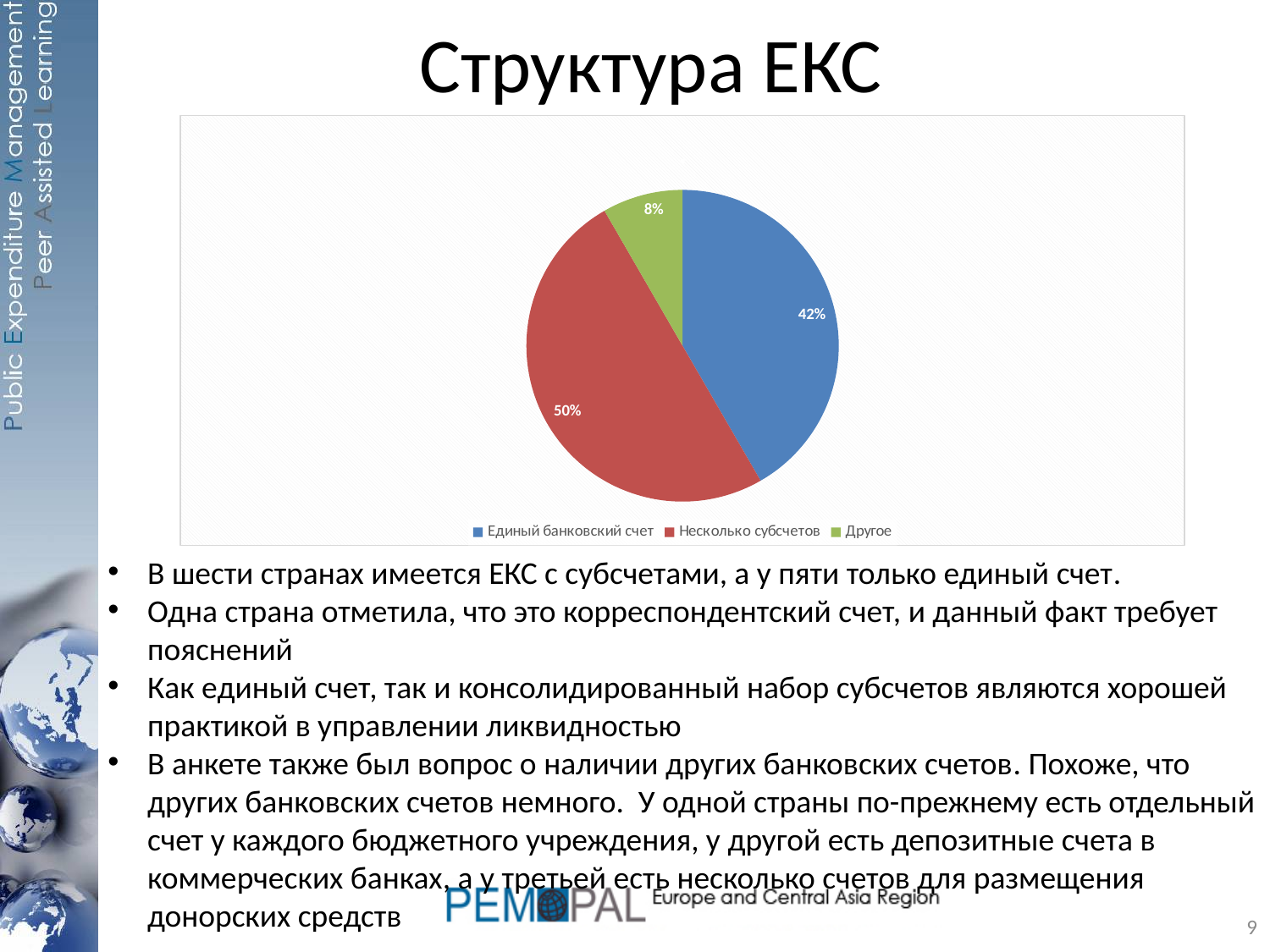
Which is larger: the slice for "Единый банковский счет" or the slice for "Другое"? Единый банковский счет What share of the pie does "Другое" have? 8% What share of the pie does "Несколько субсчетов" have? 50% What colour is the slice for "Несколько субсчетов"? red Which category has the smallest slice of the pie? Другое What share of the pie does "Единый банковский счет" have? 42% What kind of chart is shown on the slide? pie chart How many entries does the legend list? 3 Which category has the largest slice of the pie? Несколько субсчетов How many categories does the pie chart show? 3 What is the title of the slide containing the chart? Структура ЕКС What is the difference in percentage points between "Несколько субсчетов" and "Единый банковский счет"? 8